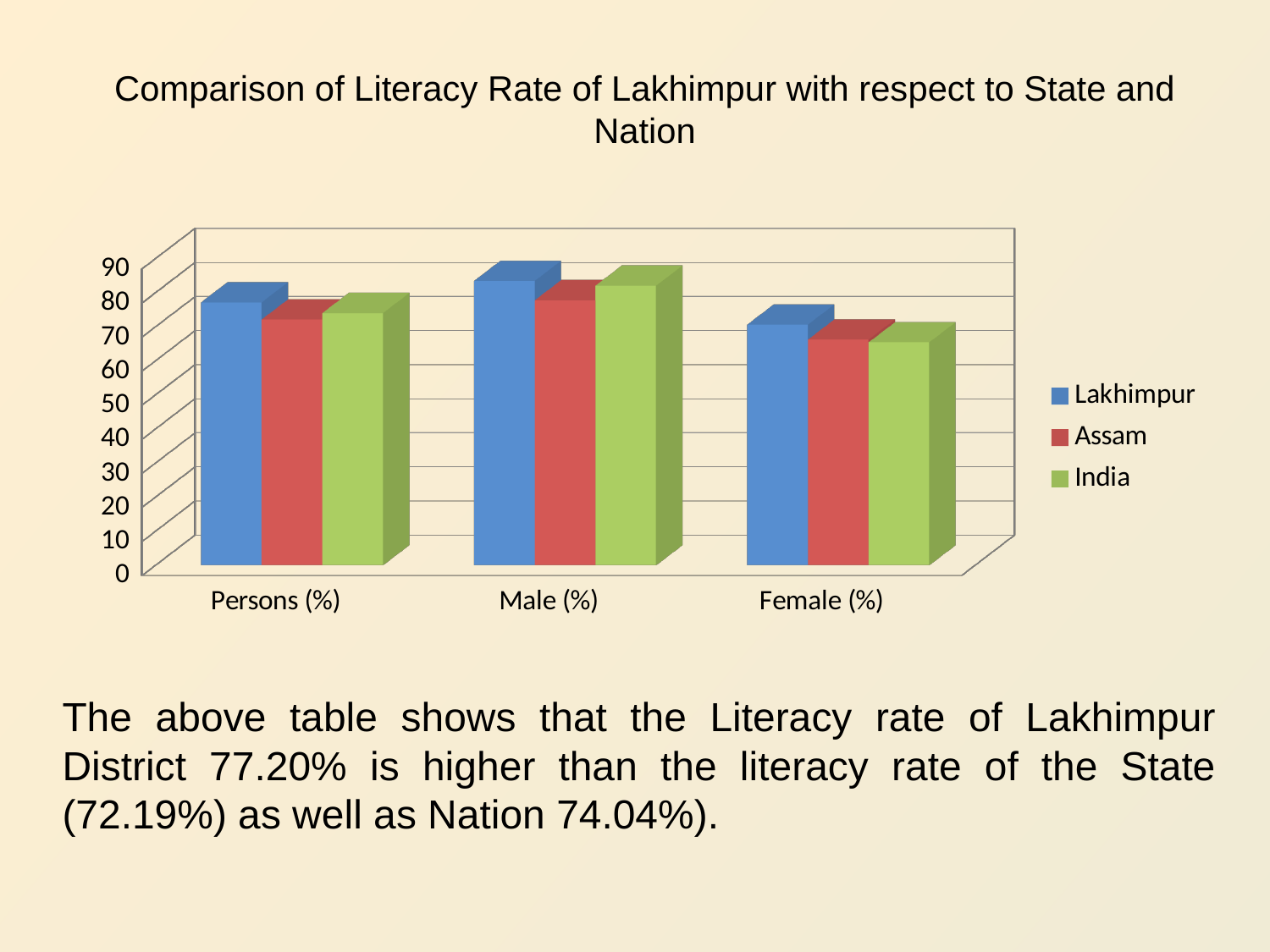
For Persons (%), which is higher: Lakhimpur or Assam? Lakhimpur According to the slide, what is the literacy rate of the State (Assam) for Persons (%)? 72.19% For which category is the India bar the lowest? Female (%) Is the value for Lakhimpur in Male (%) greater or less than 80? greater What type of chart is shown on the slide? bar chart How many series does the legend list? 3 How many categories are shown on the x axis? 3 For which category is the Lakhimpur bar the highest? Male (%) According to the slide, what is the literacy rate of Lakhimpur District for Persons (%)? 77.20% Which series is shown in red in the legend? Assam According to the slide, what is the literacy rate of the Nation (India) for Persons (%)? 74.04% Is the value for India in Female (%) greater or less than 70? less